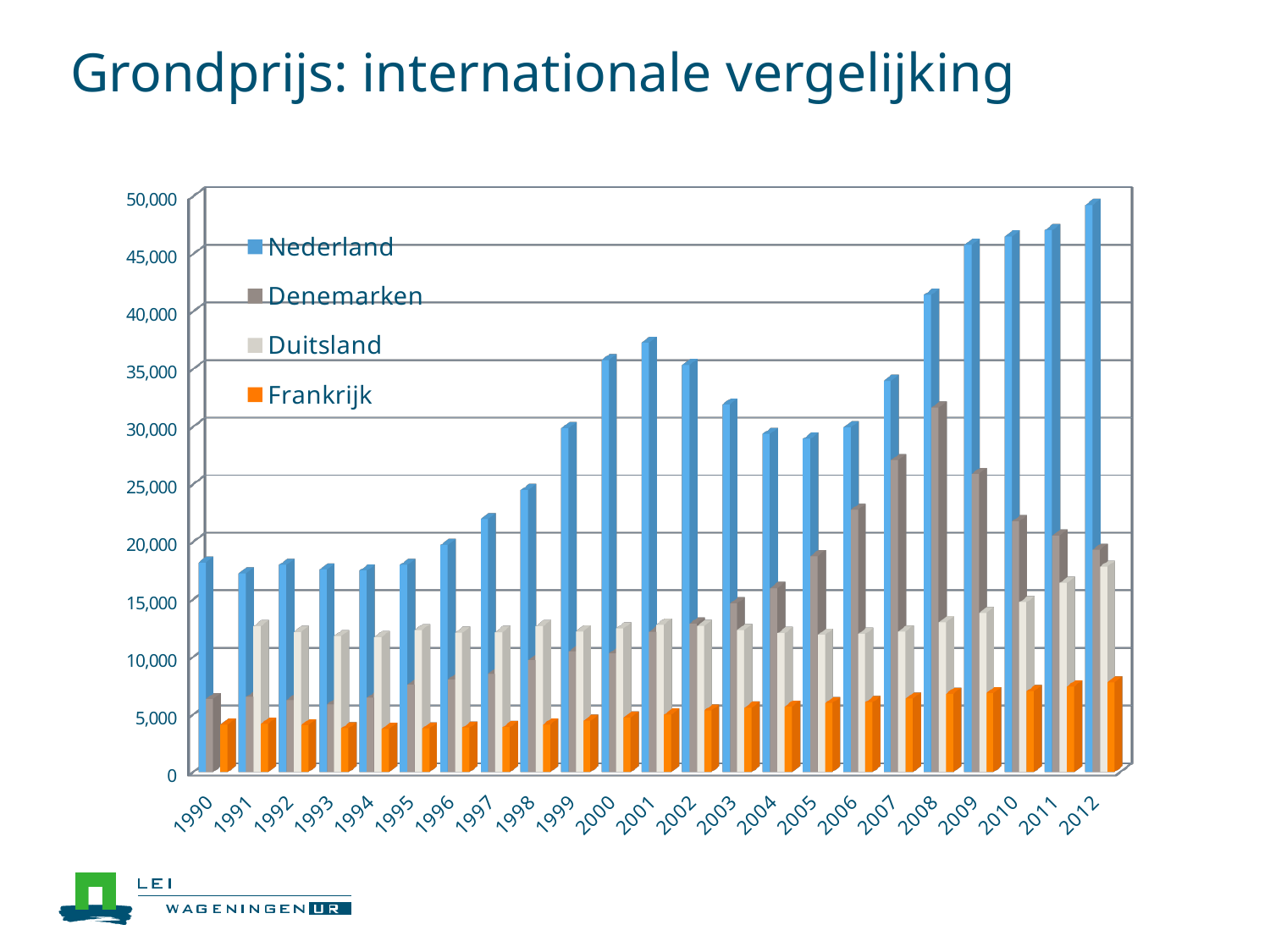
How many series does the legend list? 4 In which year is the value for Denemarken highest? 2008 How many years are shown on the x axis? 23 Which series has the lowest value in 1990? Frankrijk In which year is the value for Nederland highest? 2012 What kind of chart is shown on the slide? bar chart Is the value for Nederland in 2012 greater or less than 45,000? greater Is the value for Nederland in 1990 greater or less than 20,000? less Is the value for Denemarken in 2008 greater or less than 25,000? greater In 2008, which is larger: the value for Nederland or the value for Denemarken? Nederland What is the title of the slide? Grondprijs: internationale vergelijking Do the values for Frankrijk generally rise or fall from 1990 to 2012? rise